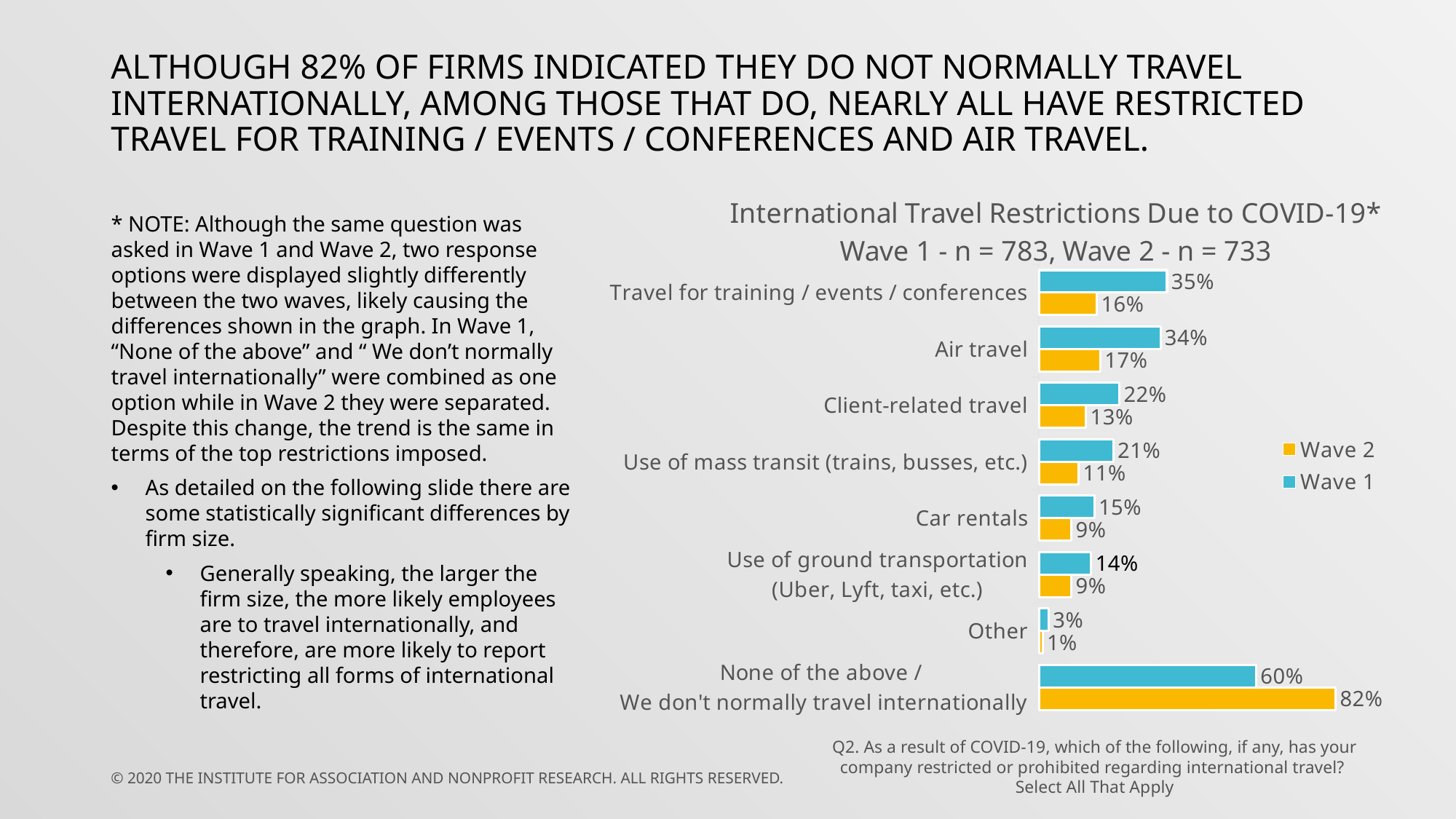
What kind of chart is shown on the slide? Bar chart Which colour represents Wave 2 in the chart? Yellow What is the Wave 2 value for Travel for training / events / conferences? 16% Which is larger for Car rentals, the Wave 1 value or the Wave 2 value? Wave 1 What is the Wave 2 value for None of the above / We don't normally travel internationally? 82% How many categories are shown on the chart? 8 Which category has the lowest Wave 2 value? Other Which category has the highest Wave 1 value? None of the above / We don't normally travel internationally How many series does the legend list? 2 What is the Wave 1 value for Use of mass transit (trains, busses, etc.)? 21% What is the difference between the Wave 1 and Wave 2 values for Client-related travel? 9% What is the Wave 1 value for Air travel? 34%